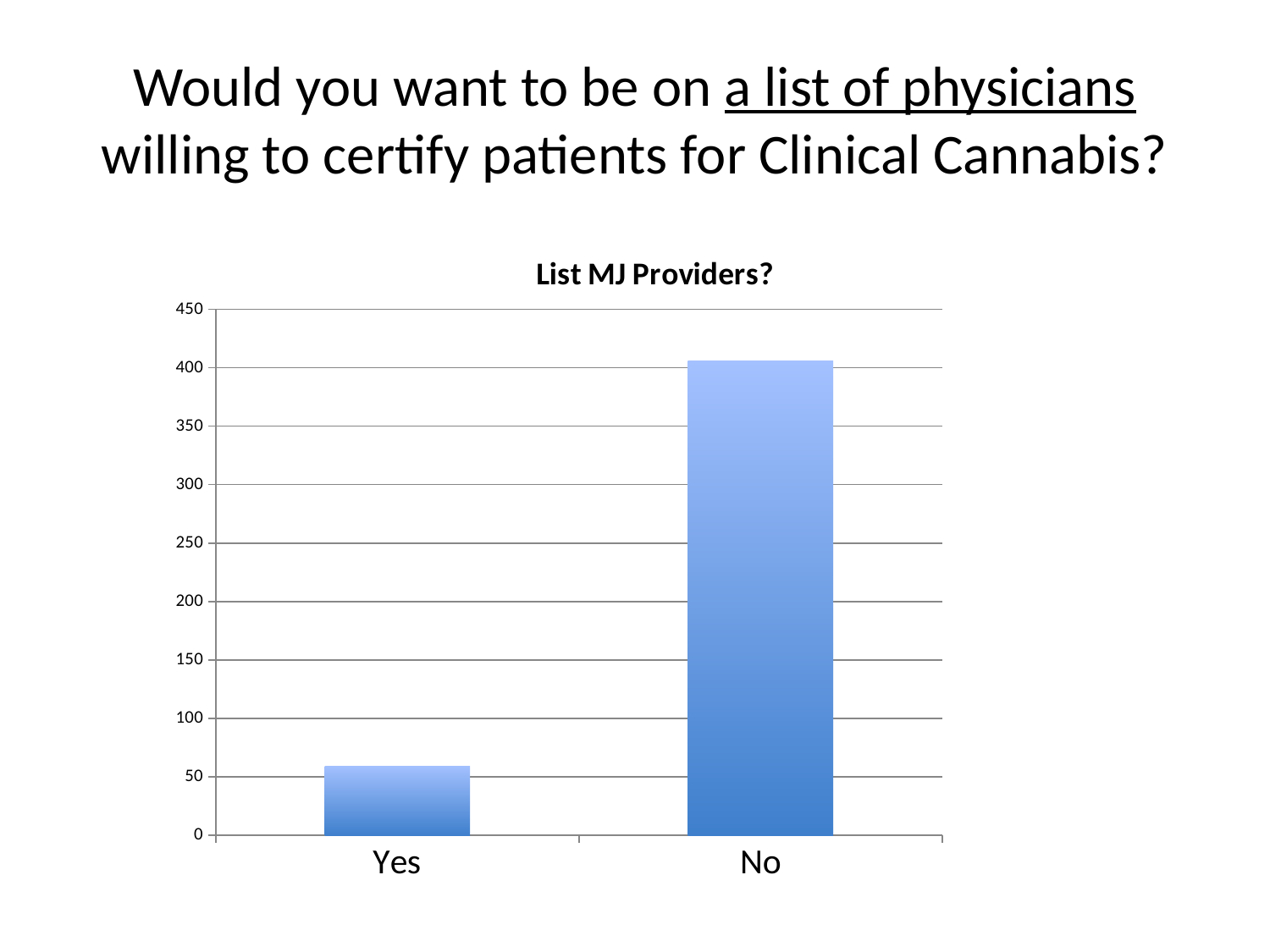
Which is larger, the value for Yes or the value for No? No Which category has the highest value? No Is the value for Yes greater or less than 100? less What kind of chart is shown on the slide? bar chart Is the value for Yes greater or less than 50? greater Is the value for No greater or less than 400? greater How many categories are shown on the x axis? 2 Which category has the lowest value? Yes What is the title of the chart? List MJ Providers? What is the highest value shown on the y axis? 450